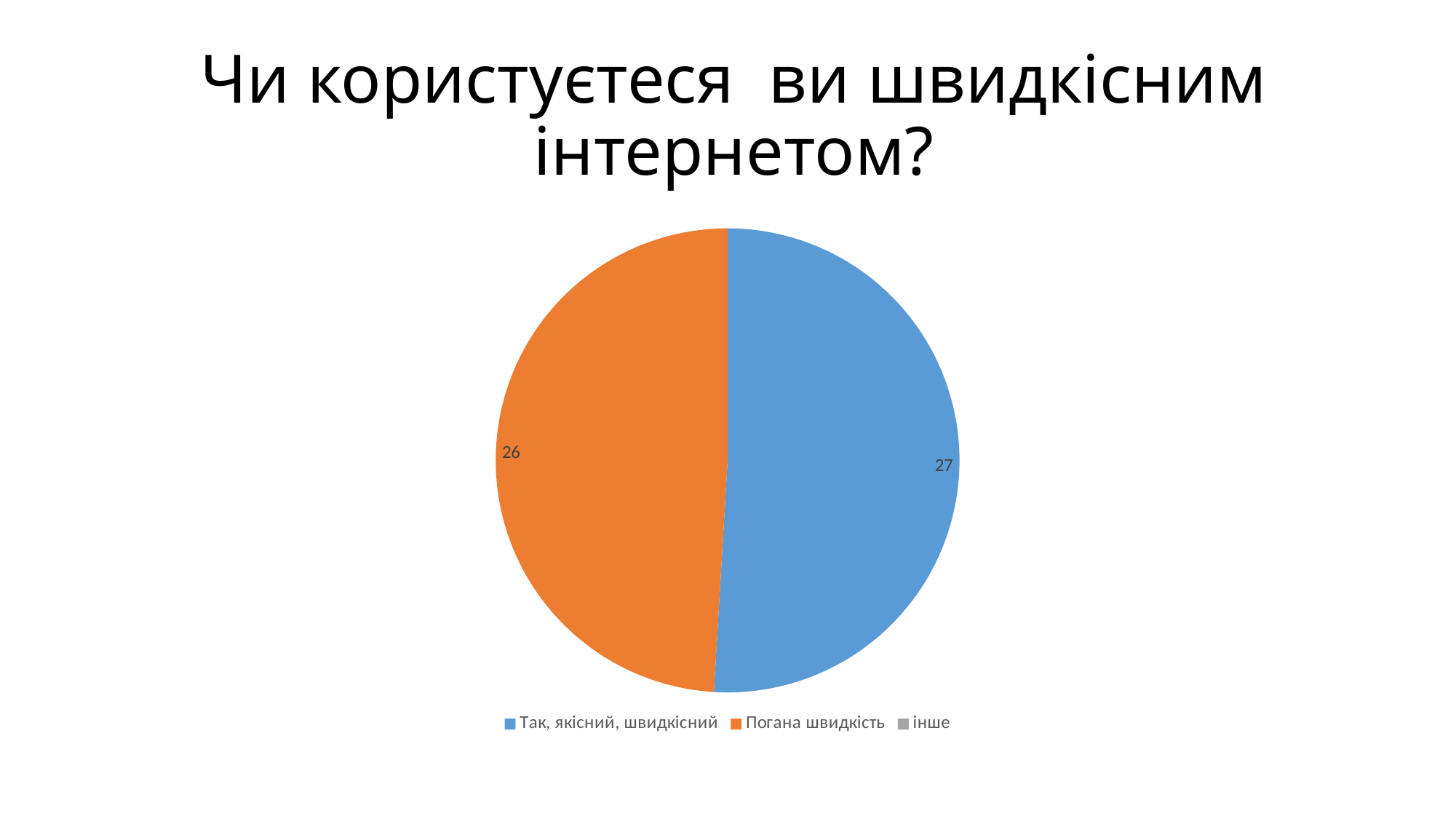
What is the value for "Так, якісний, швидкісний"? 27 What is the difference between the values for "Так, якісний, швидкісний" and "Погана швидкість"? 1 What kind of chart is shown on the slide? pie chart How many slices are visible in the pie? 2 What is the title of the slide? Чи користуєтеся ви швидкісним інтернетом? What colour is the slice for "Погана швидкість"? orange How many categories does the legend list? 3 Which category has the largest slice? Так, якісний, швидкісний Which of the two labelled slices has the smaller value? Погана швидкість Which is larger: the value for "Так, якісний, швидкісний" or for "Погана швидкість"? Так, якісний, швидкісний What is the value for "Погана швидкість"? 26